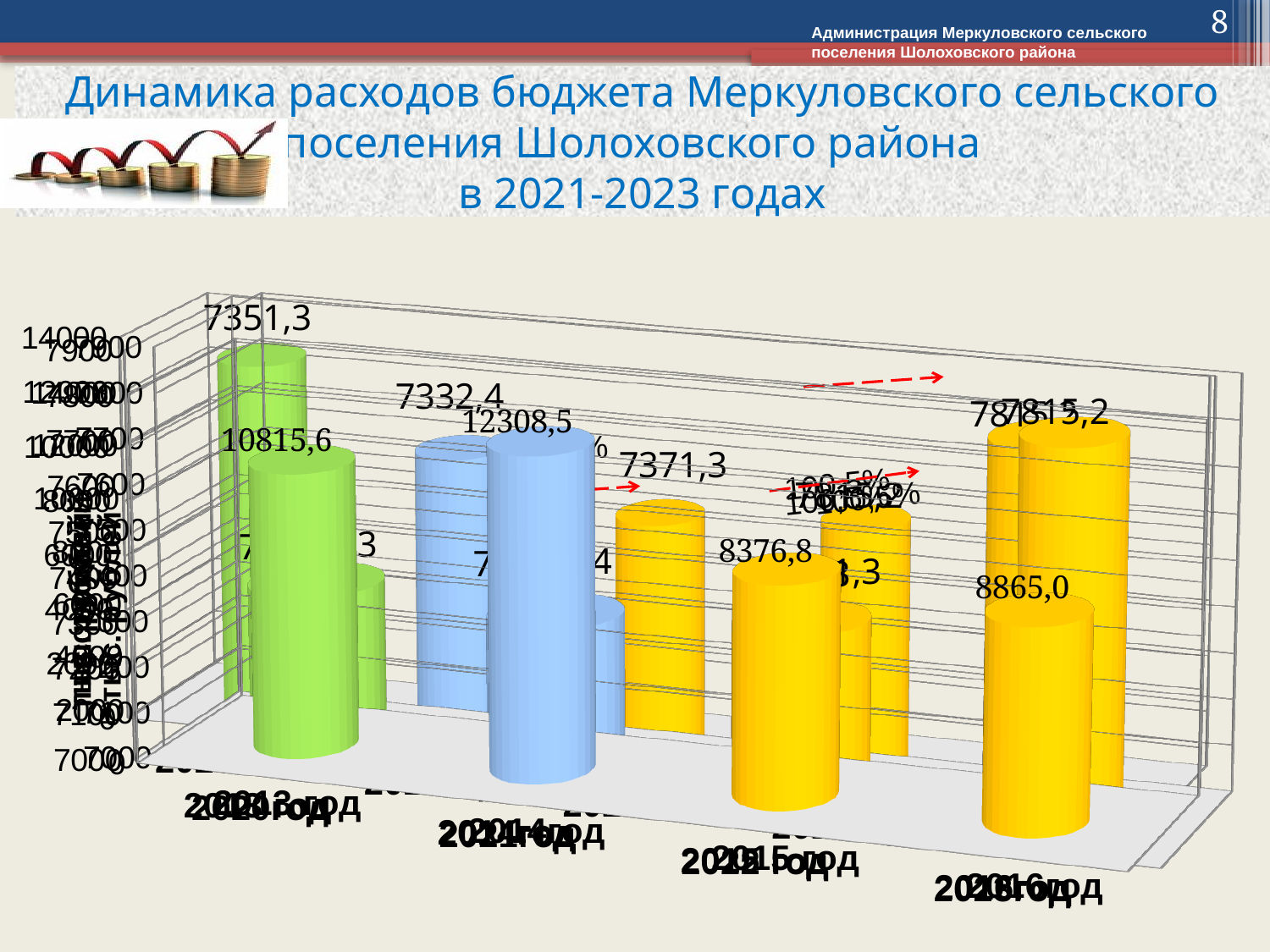
What kind of chart is shown on the slide? bar chart What is the largest value printed as a data label on the chart? 12308,5 What colours are the bars in the chart? green, blue and yellow What is the title of the slide containing the chart? Динамика расходов бюджета Меркуловского сельского поселения Шолоховского района в 2021-2023 годах What is the value printed on the tallest blue bar? 12308,5 Which printed value is larger, 10815,6 on the green bar or 12308,5 on the blue bar? 12308,5 What is the difference between the printed values 12308,5 and 10815,6? 1492,9 What is the difference between the printed values 8865,0 and 8376,8 on the yellow bars? 488,2